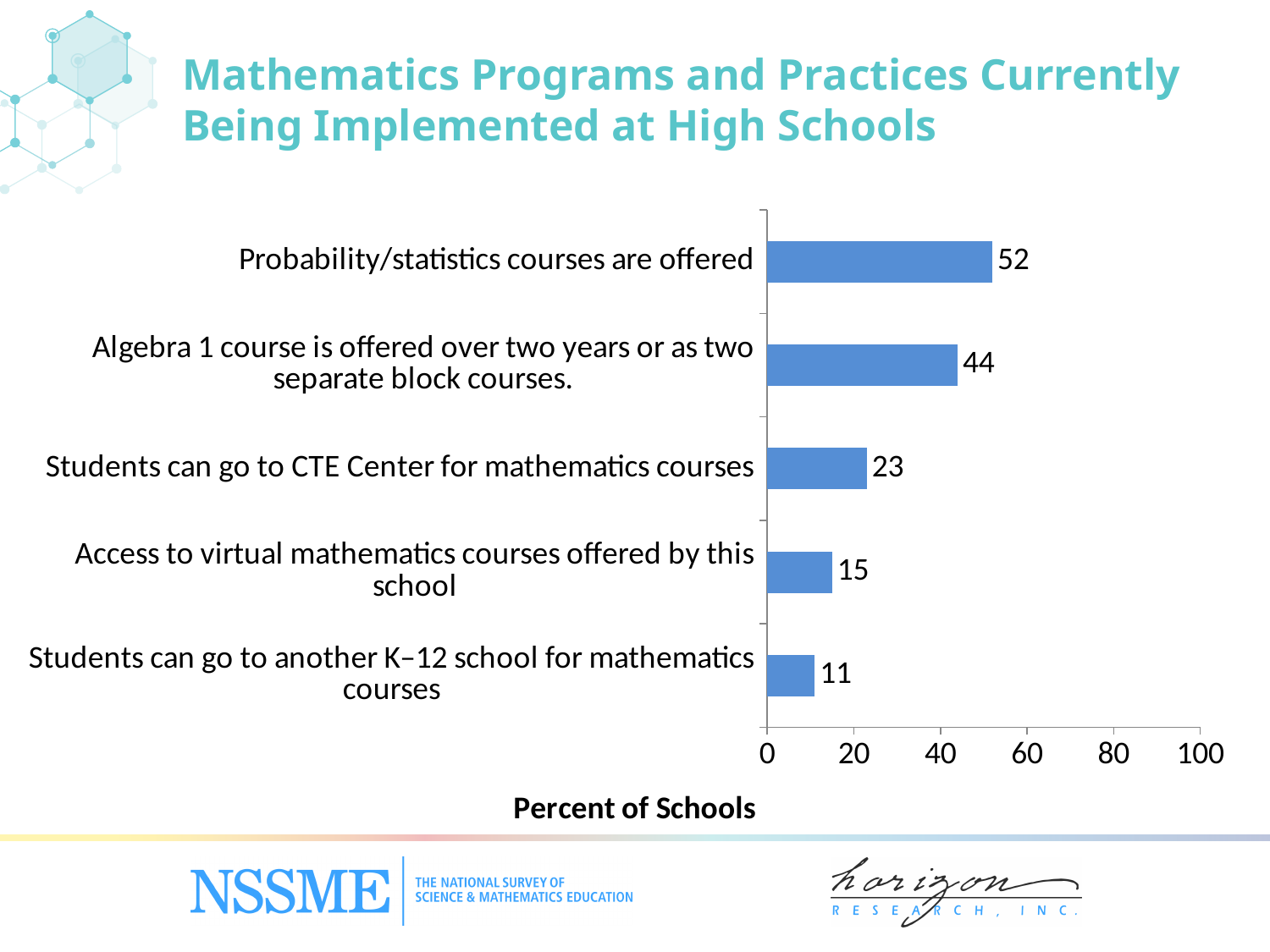
Is the value for 'Algebra 1 course is offered over two years or as two separate block courses.' greater or less than 40? greater How many programs or practices are shown in the chart? 5 Which program or practice has the lowest percent of schools? Students can go to another K–12 school for mathematics courses Which program or practice has the highest percent of schools? Probability/statistics courses are offered What is the label of the horizontal axis? Percent of Schools Which is larger: the value for 'Students can go to CTE Center for mathematics courses' or the value for 'Access to virtual mathematics courses offered by this school'? Students can go to CTE Center for mathematics courses What percent of schools report access to virtual mathematics courses offered by this school? 15 What is the maximum value shown on the horizontal axis? 100 What kind of chart is shown on the slide? Bar chart What is the difference between the percent of schools offering probability/statistics courses and the percent offering Algebra 1 over two years or as two block courses? 8 What percent of schools offer probability/statistics courses? 52 What is the value for 'Students can go to CTE Center for mathematics courses'? 23